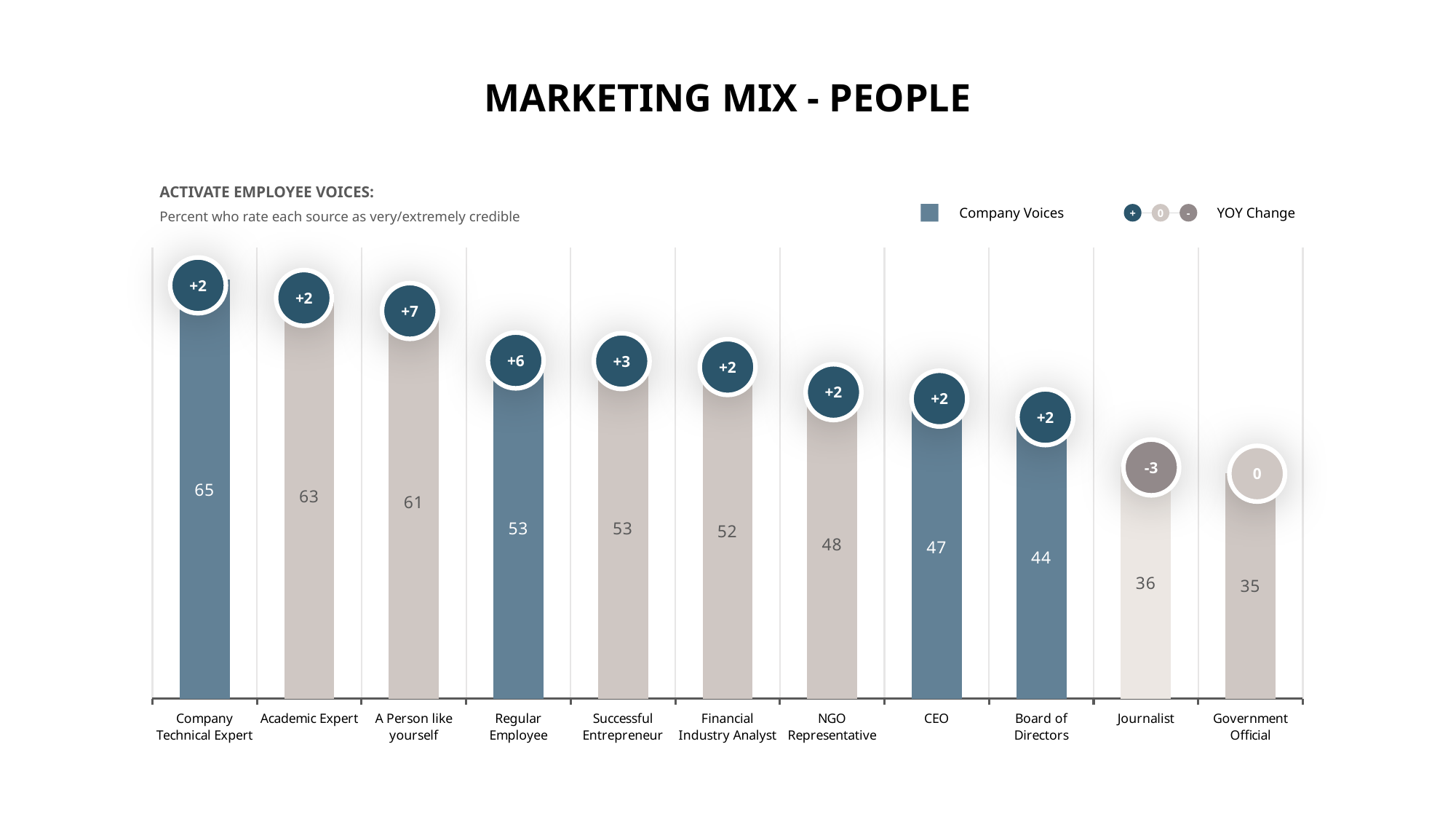
Which source has the highest credibility percentage? Company Technical Expert Which source has the lowest credibility percentage? Government Official What percent rate Company Technical Expert as very/extremely credible? 65 Do the values rise or fall from left to right across the chart? Fall Which is larger, the value for CEO or the value for Board of Directors? CEO What is the YOY change shown for A Person like yourself? +7 How many sources are shown on the chart? 11 What is the value shown for Journalist? 36 What is the YOY change shown for Journalist? -3 Which source has the largest YOY change? A Person like yourself What is the difference between the values for Company Technical Expert and Government Official? 30 What kind of chart is shown on the slide? Bar chart